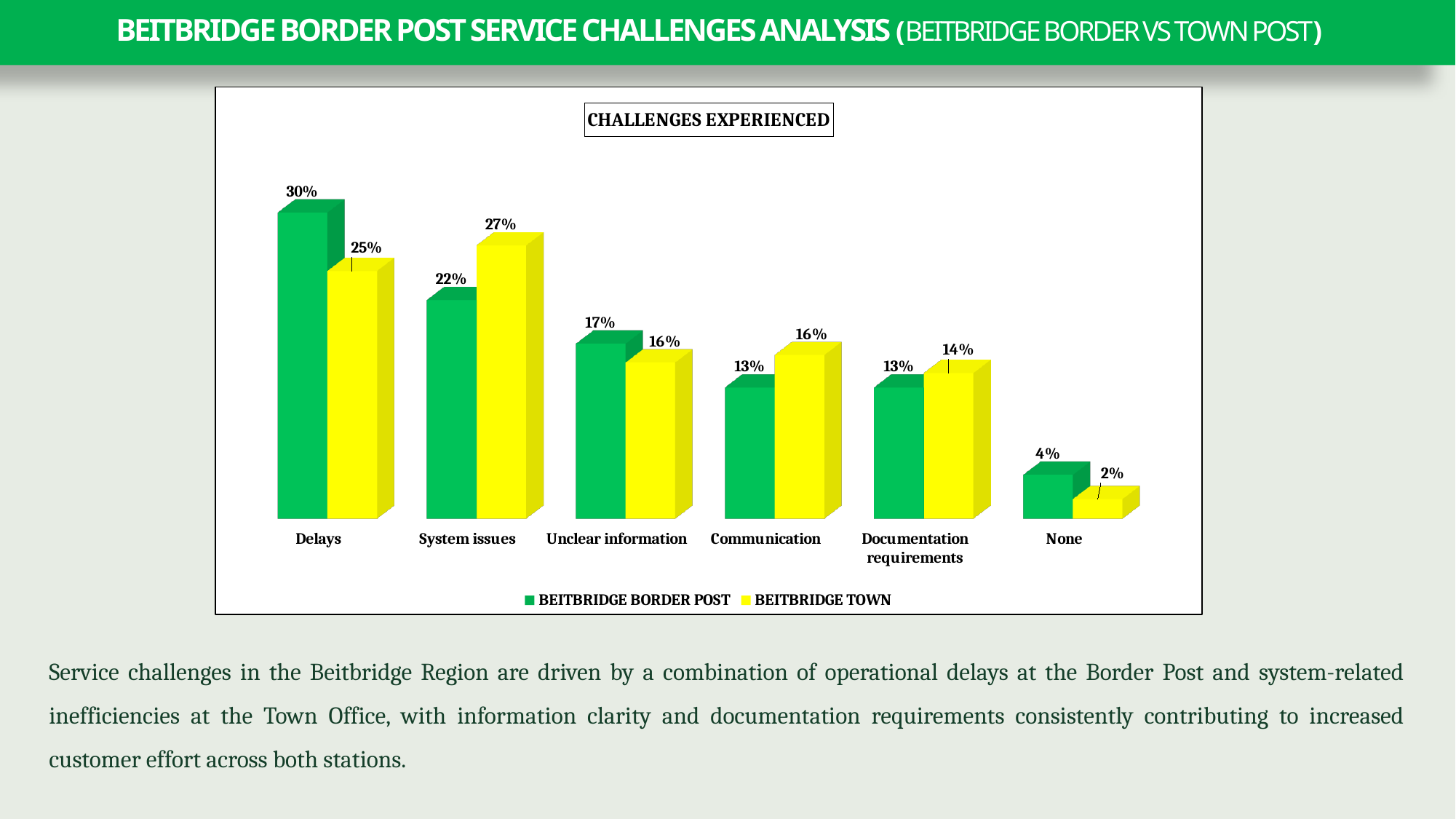
What is the difference between the BEITBRIDGE TOWN and BEITBRIDGE BORDER POST values for System issues? 5% How many series does the legend list? 2 What is the value for System issues for the BEITBRIDGE TOWN series? 27% Which series has the larger value for Communication? BEITBRIDGE TOWN What is the value for Documentation requirements for the BEITBRIDGE TOWN series? 14% What is the value for Delays for the BEITBRIDGE BORDER POST series? 30% How many categories are shown on the x axis? 6 Which category has the highest value for the BEITBRIDGE BORDER POST series? Delays What kind of chart is shown on the slide? Bar chart Which category has the lowest value for the BEITBRIDGE TOWN series? None What is the title of the chart? CHALLENGES EXPERIENCED What is the difference between the BEITBRIDGE BORDER POST and BEITBRIDGE TOWN values for Delays? 5%